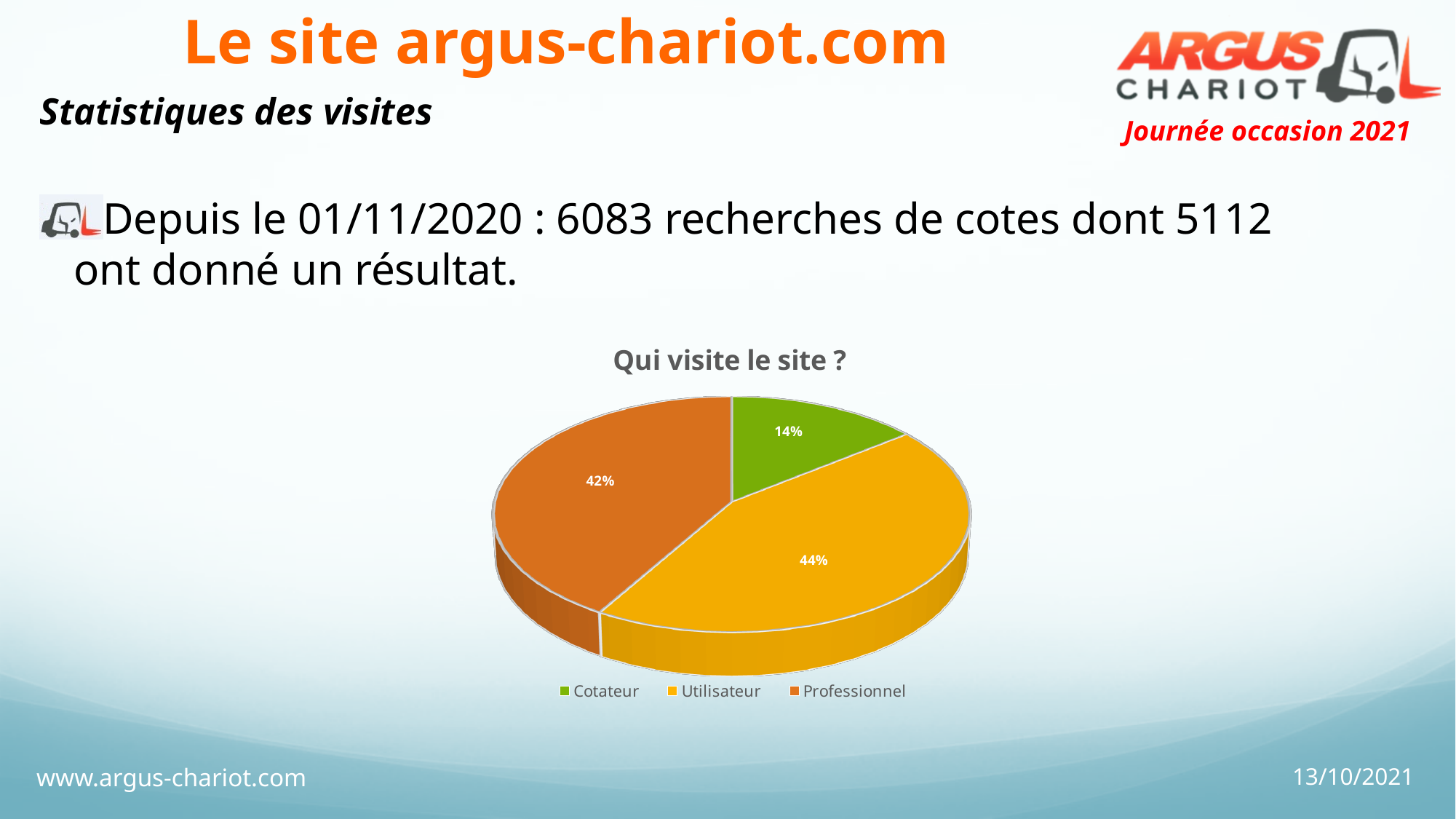
What kind of chart is shown on the slide? Pie chart What is the difference in percentage points between the Utilisateur and Cotateur slices? 30 Which colour represents Cotateur in the legend? Green Which slice is larger, Professionnel or Cotateur? Professionnel How many categories does the pie chart show? 3 What is the difference in percentage points between the Professionnel and Cotateur slices? 28 Which category has the largest slice of the pie? Utilisateur What share of the pie does Professionnel represent? 42% What share of the pie does Cotateur represent? 14% What share of the pie does Utilisateur represent? 44% Which category has the smallest slice of the pie? Cotateur What is the title of the chart? Qui visite le site ?